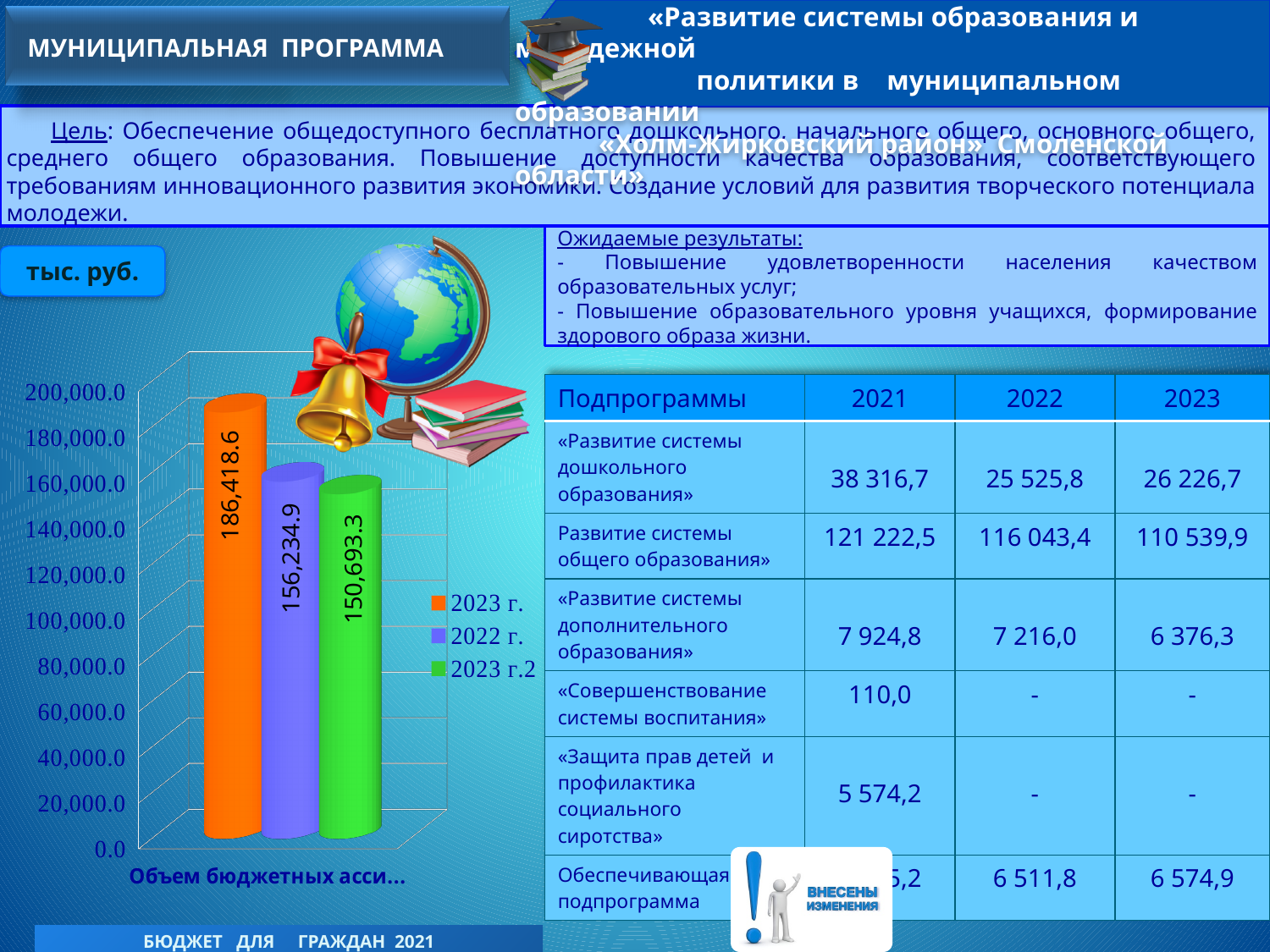
Which legend series has the lowest bar in the chart? 2023 г.2 How many series does the chart legend list? 3 What is the value of the orange bar labelled "2023 г." in the chart? 186,418.6 What kind of chart is shown on the slide? bar chart What unit is indicated in the label box next to the chart? тыс. руб. What is the value of the green bar labelled "2023 г.2" in the chart? 150,693.3 What is the value of the bar for the series "2022 г." in the chart? 156,234.9 What is the difference between the "2023 г." bar and the "2022 г." bar in the chart? 30,183.7 Is the value of the "2023 г." bar greater or less than 180,000.0? greater Which is larger in the chart, the "2022 г." bar or the "2023 г.2" bar? 2022 г. Which legend series has the highest bar in the chart? 2023 г. What is the difference between the "2022 г." bar and the "2023 г.2" bar in the chart? 5,541.6